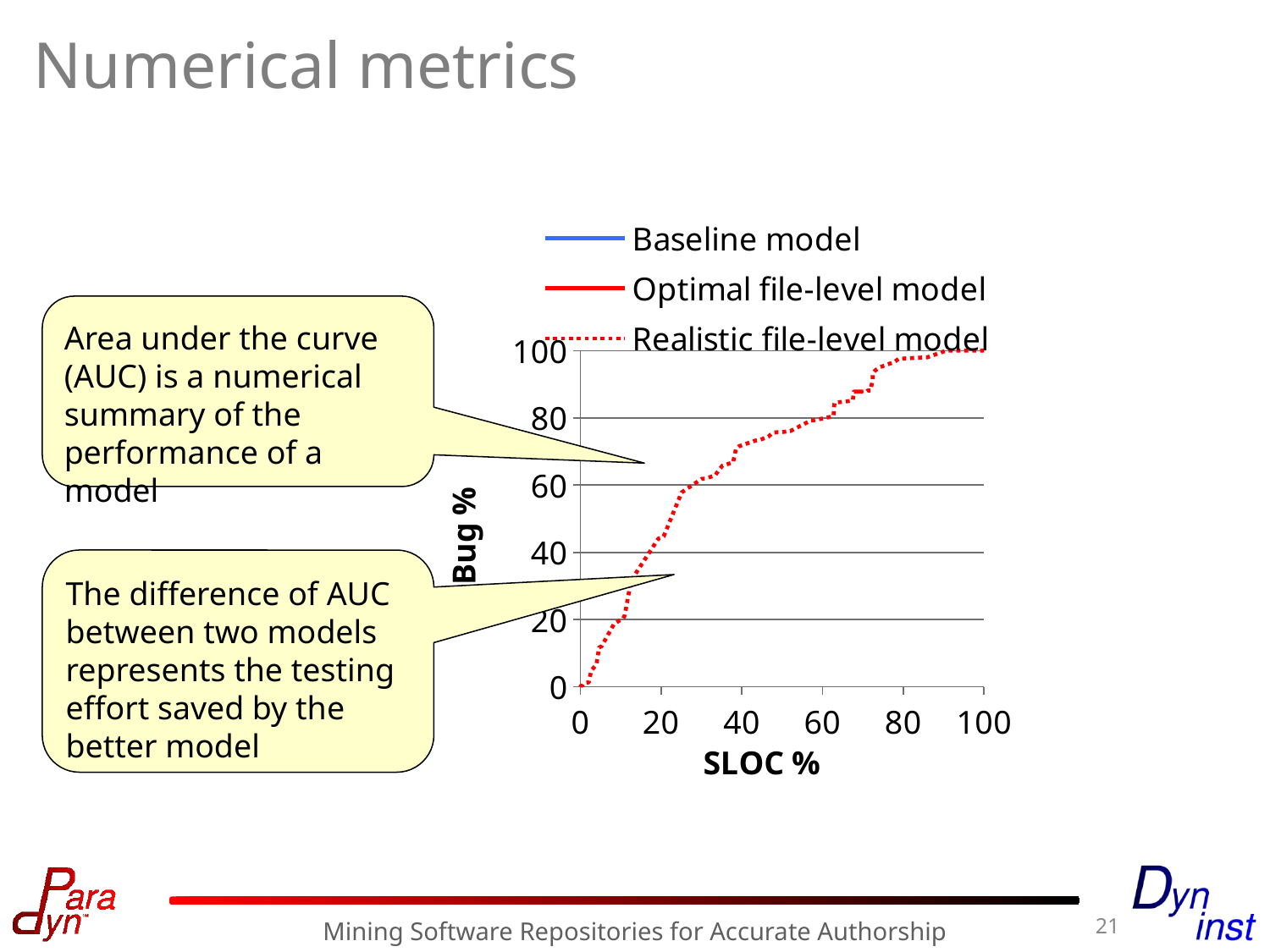
Which is larger for the Realistic file-level model: the Bug % at 20 SLOC % or the Bug % at 60 SLOC %? 60 SLOC % What is the Bug % value of the Realistic file-level model at 0 SLOC %? 0 What is the label of the x axis of the chart? SLOC % Is the Bug % value of the Realistic file-level model at 60 SLOC % greater or less than 60? greater Does the Realistic file-level model line rise or fall as SLOC % increases? rise Is the Bug % value of the Realistic file-level model at 40 SLOC % greater or less than 60? greater What is the label of the y axis of the chart? Bug % What is the Bug % value of the Realistic file-level model at 100 SLOC %? 100 Is the Bug % value of the Realistic file-level model at 20 SLOC % greater or less than 60? less What kind of chart is shown on the slide? line chart How many series does the chart's legend list? 3